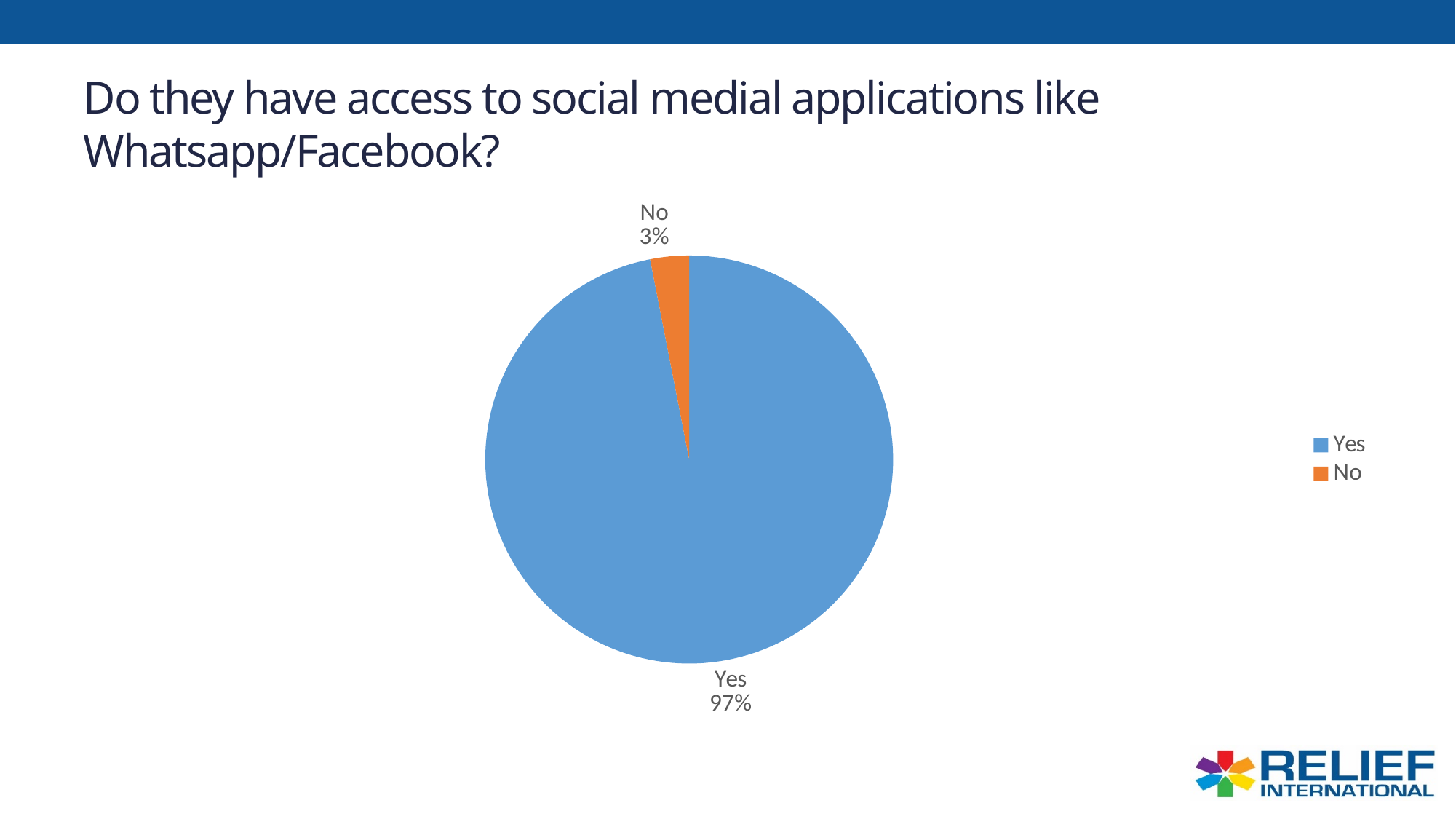
What share of the pie does the No slice represent? 3% What kind of chart is shown on the slide? Pie chart Which category has the smallest share of the pie? No What percentage of respondents answered No? 3% Which category has the largest share of the pie? Yes What question does the slide title ask? Do they have access to social medial applications like Whatsapp/Facebook? How many entries does the legend list? 2 What colour is the Yes slice? Blue Which is larger, the Yes slice or the No slice? Yes What is the difference in percentage points between the Yes and No slices? 94 How many slices does the pie chart have? 2 What percentage of respondents answered Yes? 97%